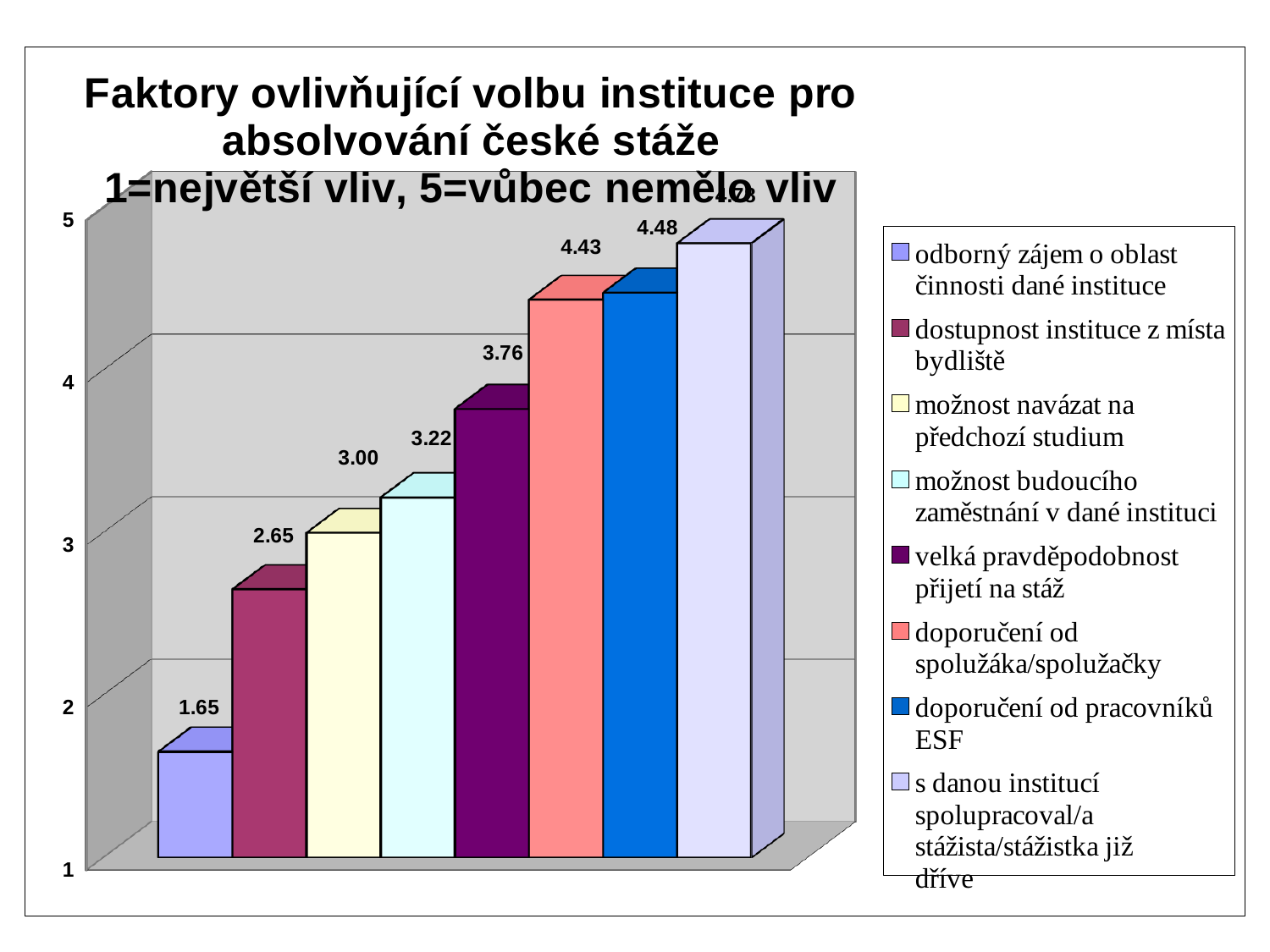
What is the value for "možnost navázat na předchozí studium"? 3.00 What kind of chart is shown on the slide? bar chart What is the value for "velká pravděpodobnost přijetí na stáž"? 3.76 What is the value for "doporučení od spolužáka/spolužačky"? 4.43 Which factor has the lowest value? odborný zájem o oblast činnosti dané instituce What is the value for "možnost budoucího zaměstnání v dané instituci"? 3.22 What is the difference between the values for "velká pravděpodobnost přijetí na stáž" and "dostupnost instituce z místa bydliště"? 1.11 What is the value for "doporučení od pracovníků ESF"? 4.48 How many entries does the legend list? 8 What is the value for "dostupnost instituce z místa bydliště"? 2.65 Which is larger: the value for "možnost budoucího zaměstnání v dané instituci" or for "možnost navázat na předchozí studium"? možnost budoucího zaměstnání v dané instituci What is the value for "odborný zájem o oblast činnosti dané instituce"? 1.65